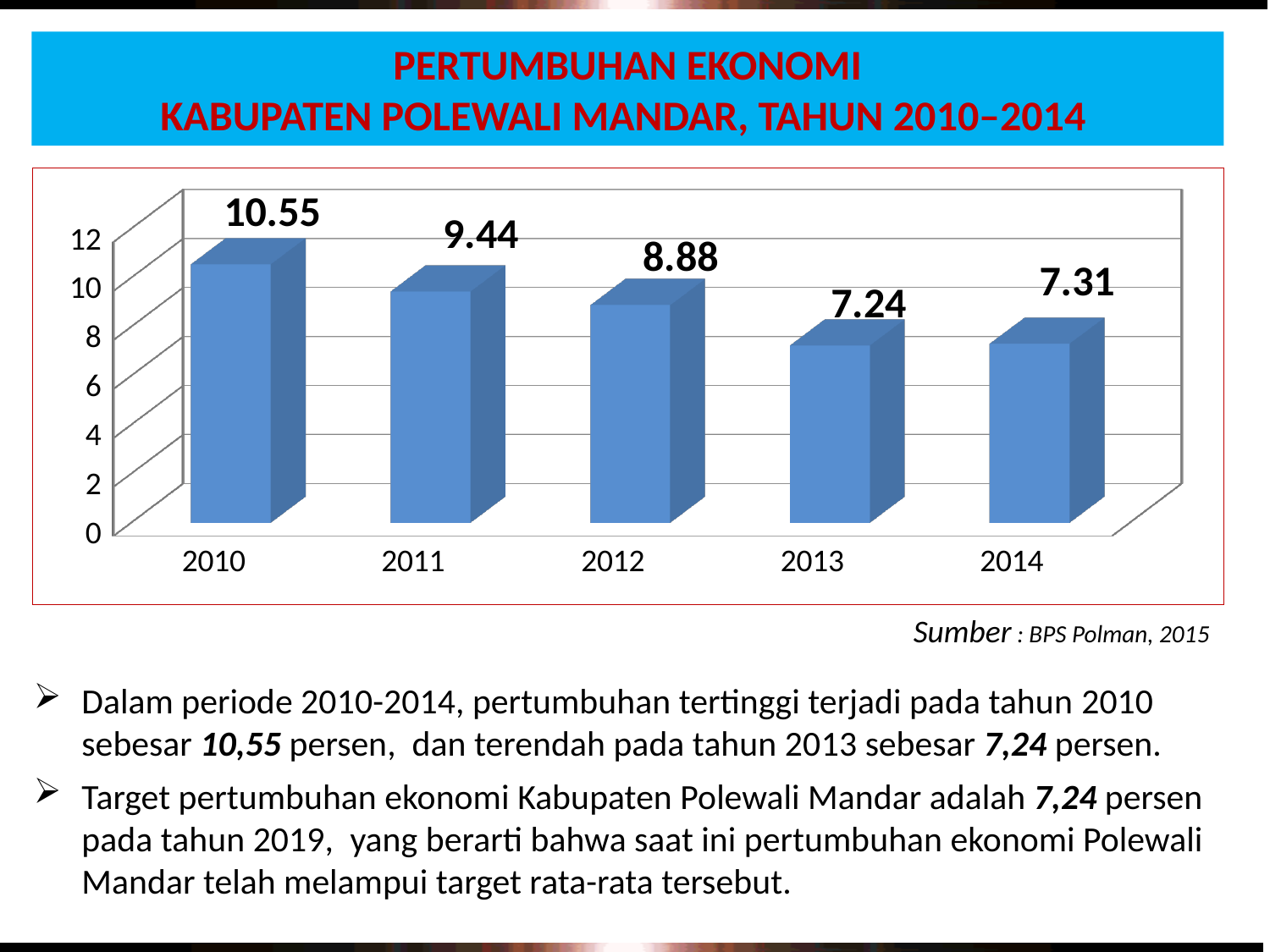
What is the value shown for 2014? 7.31 What is the difference between the values for 2011 and 2012? 0.56 What is the value shown for 2013? 7.24 What kind of chart is shown on the slide? bar chart Which year has the highest value in the chart? 2010 What is the economic growth value shown for 2010? 10.55 How many years are shown on the x axis of the chart? 5 What is the difference between the values for 2010 and 2013? 3.31 Which is larger, the value for 2011 or the value for 2012? 2011 Do the values generally rise or fall from 2010 to 2013? fall Is the value for 2012 greater or less than 8? greater Which year has the lowest value in the chart? 2013